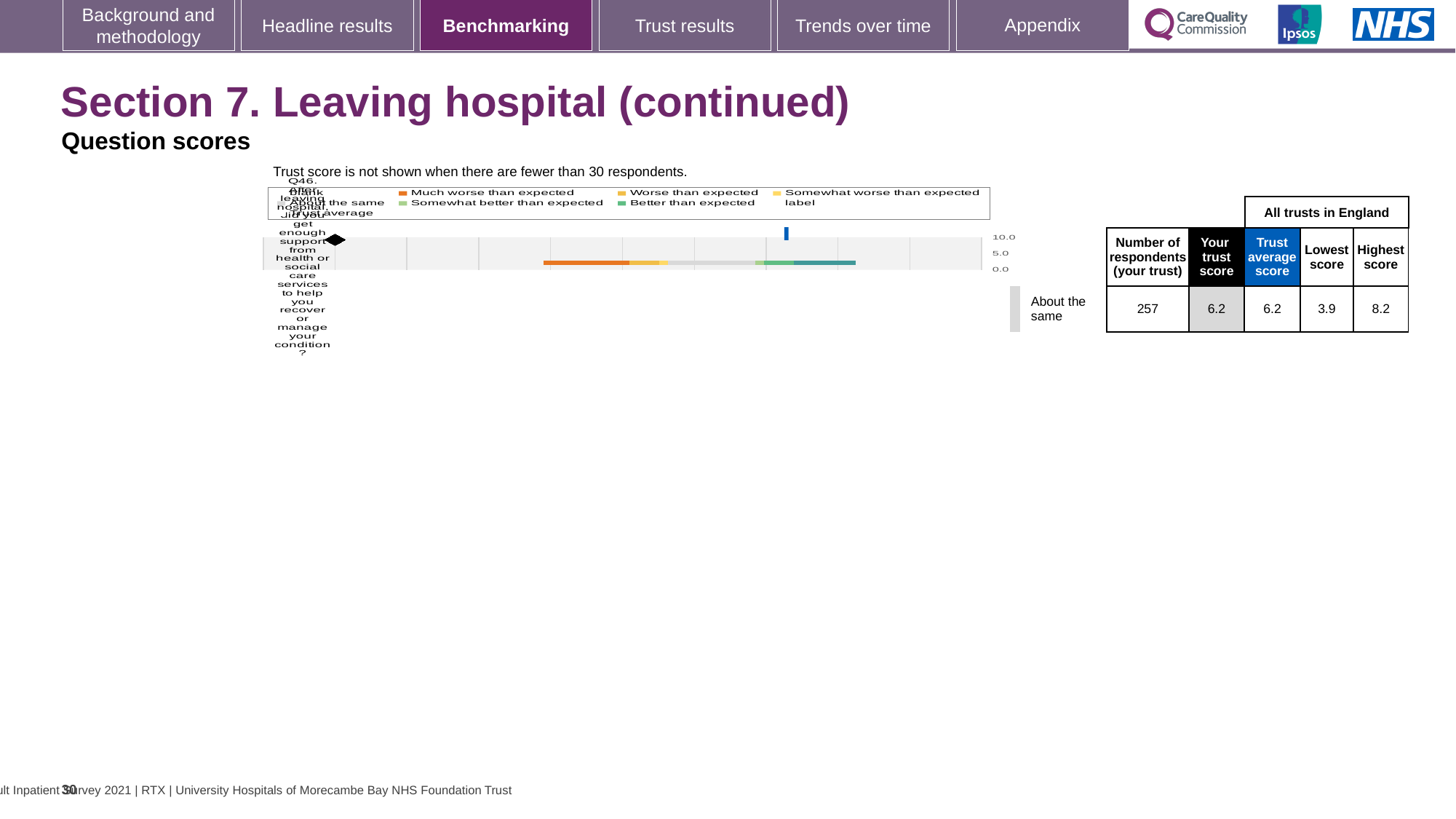
What is the highest score among all trusts in England for Q46? 8.2 Which is larger for Q46: the trust's score or the highest score in England? Highest score How is the trust's Q46 result categorised relative to expectations? About the same How many respondents from the trust answered Q46? 257 What is the trust score for Q46 shown in the table? 6.2 How many questions are plotted on the benchmarking chart on this slide? 1 What is the difference between the highest and lowest scores for Q46 across all trusts in England? 4.3 What is the lowest score among all trusts in England for Q46? 3.9 What is the trust average score for Q46 across all trusts in England? 6.2 What is the maximum value shown on the chart's score axis? 10.0 What kind of chart is used to show the Q46 benchmarking result? Bar chart How much higher is the trust's score for Q46 than the lowest score in England? 2.3